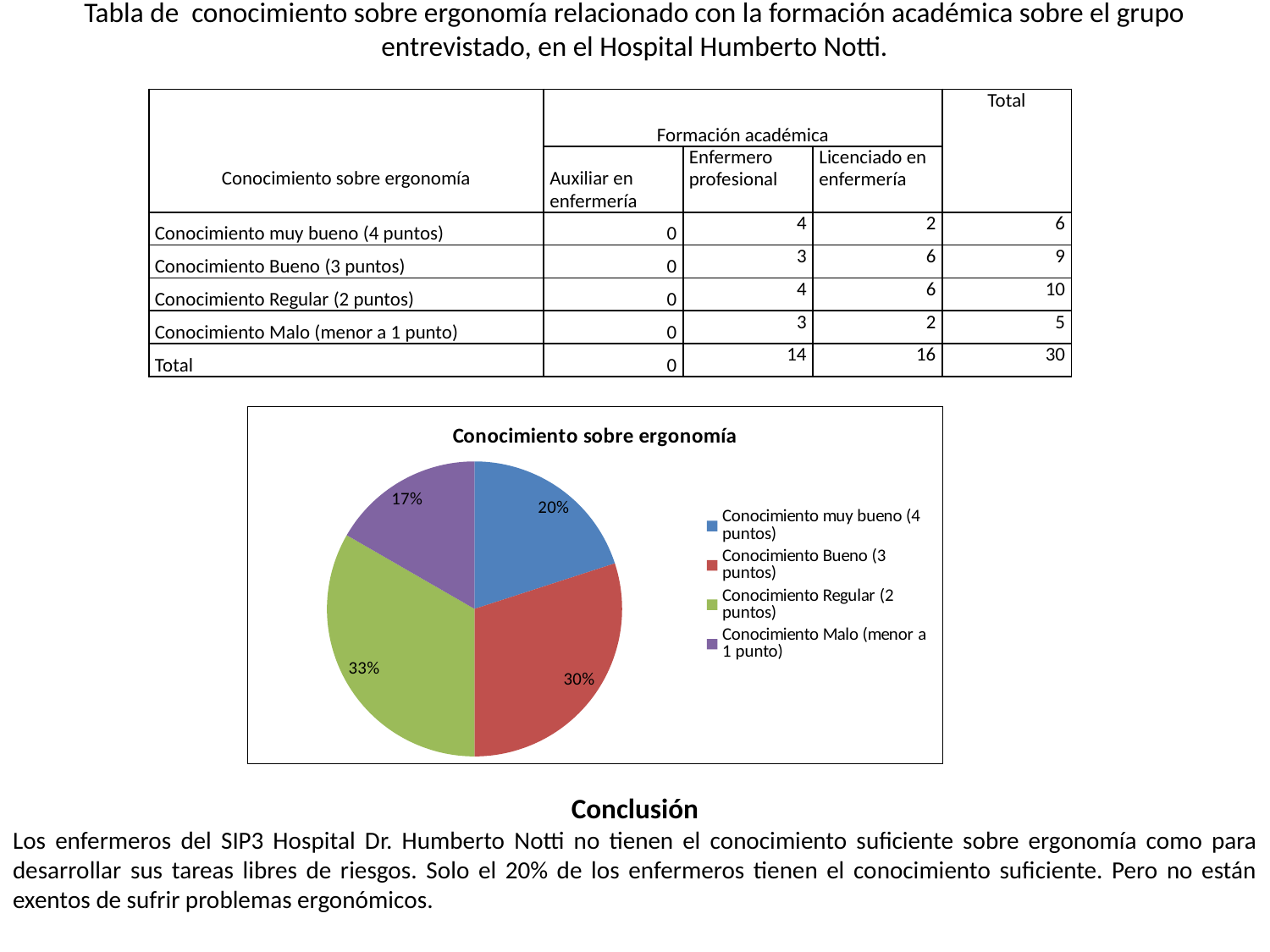
What share of the pie does 'Conocimiento Regular (2 puntos)' represent? 33% How many slices does the pie chart have? 4 What is the difference in percentage points between the 'Conocimiento Regular (2 puntos)' slice and the 'Conocimiento Malo (menor a 1 punto)' slice? 16 What is the title of the chart? Conocimiento sobre ergonomía What kind of chart is shown on the slide? Pie chart What share of the pie does 'Conocimiento muy bueno (4 puntos)' represent? 20% What share of the pie does 'Conocimiento Bueno (3 puntos)' represent? 30% Which category has the smallest slice of the pie? Conocimiento Malo (menor a 1 punto) How many entries does the chart legend list? 4 Which slice is larger: 'Conocimiento Bueno (3 puntos)' or 'Conocimiento muy bueno (4 puntos)'? Conocimiento Bueno (3 puntos) Which category has the largest slice of the pie? Conocimiento Regular (2 puntos)